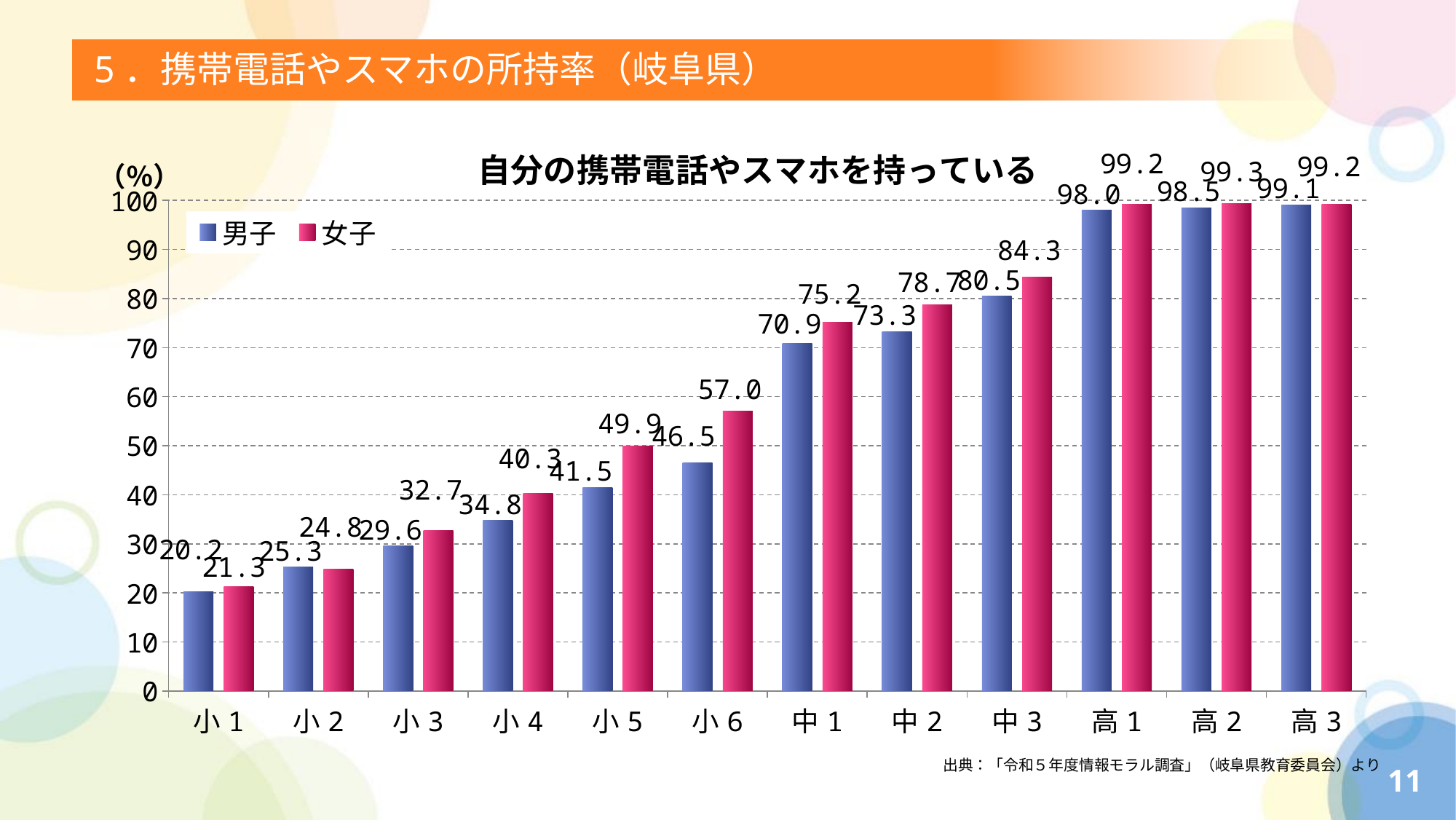
How many categories are shown on the x axis? 12 Which is larger at 小2, 男子 or 女子? 男子 What is the value for 女子 at 中1? 75.2 Which category has the lowest value for 男子? 小1 What kind of chart is shown? bar chart Which category has the highest value for 女子? 高2 What is the value for 男子 at 小6? 46.5 What is the difference between 女子 and 男子 at 小6? 10.5 What is the value for 男子 at 高1? 98.0 Is the value for 女子 at 小5 greater or less than 40? greater Do the values for 男子 rise or fall from 小1 to 高3? rise How many series does the legend list? 2